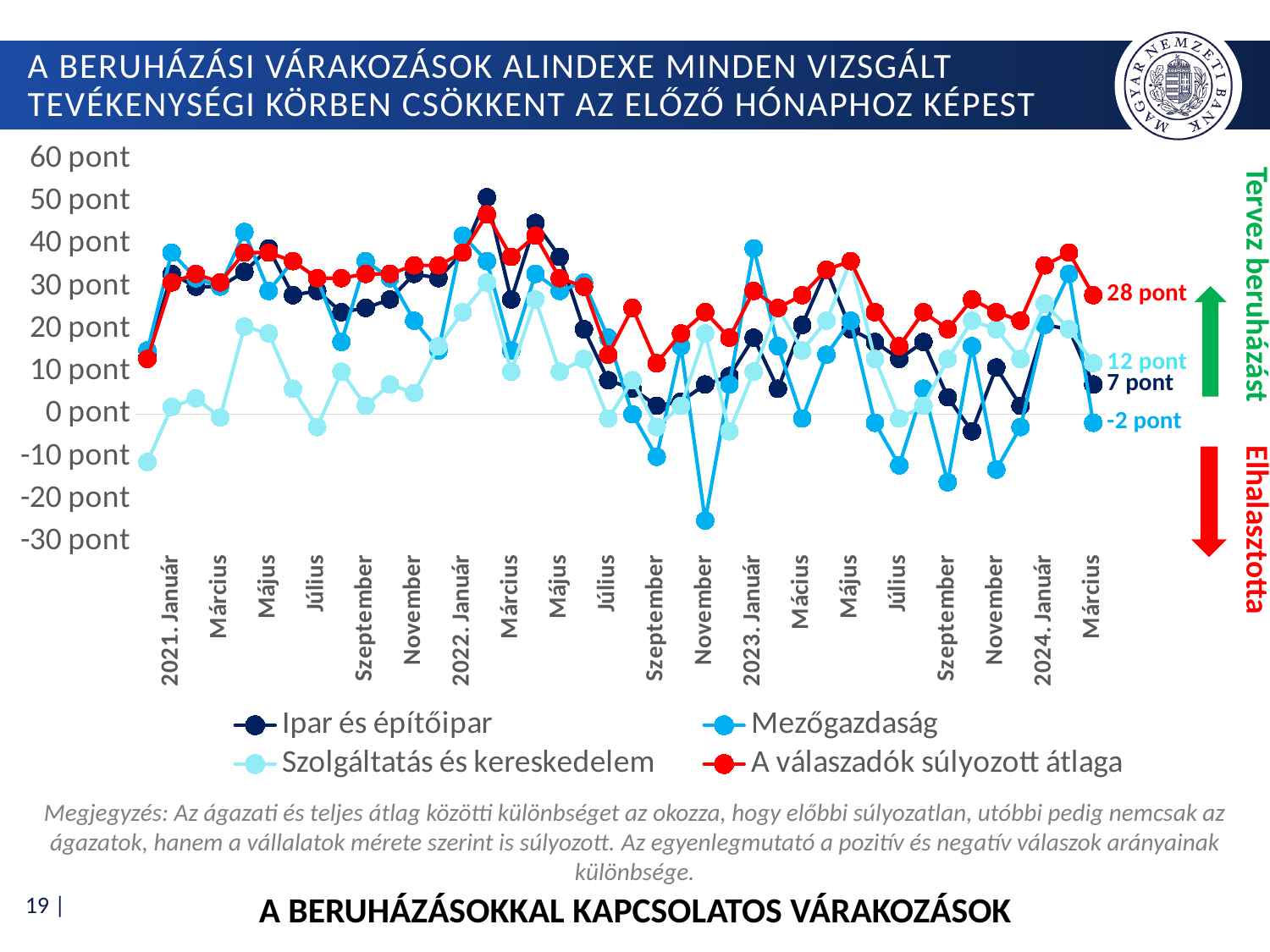
What is the difference between the labelled end values of A válaszadók súlyozott átlaga and Szolgáltatás és kereskedelem? 16 pont What kind of chart is shown on the slide? Line chart What is the value labelled for Ipar és építőipar at the end of the series (2024 Március)? 7 pont What is the difference between the labelled end values of A válaszadók súlyozott átlaga and Mezőgazdaság? 30 pont What is the value labelled for Mezőgazdaság at the end of the series (2024 Március)? -2 pont At the last data point, which is larger: Ipar és építőipar or Mezőgazdaság? Ipar és építőipar Is the value for Mezőgazdaság in 2022 November greater or less than -20 pont? less How many series does the legend list? 4 What is the value labelled for A válaszadók súlyozott átlaga at the end of the series (2024 Március)? 28 pont Which series has the lowest value at the last data point (2024 Március)? Mezőgazdaság Which series has the highest value at the last data point (2024 Március)? A válaszadók súlyozott átlaga What is the value labelled for Szolgáltatás és kereskedelem at the end of the series (2024 Március)? 12 pont